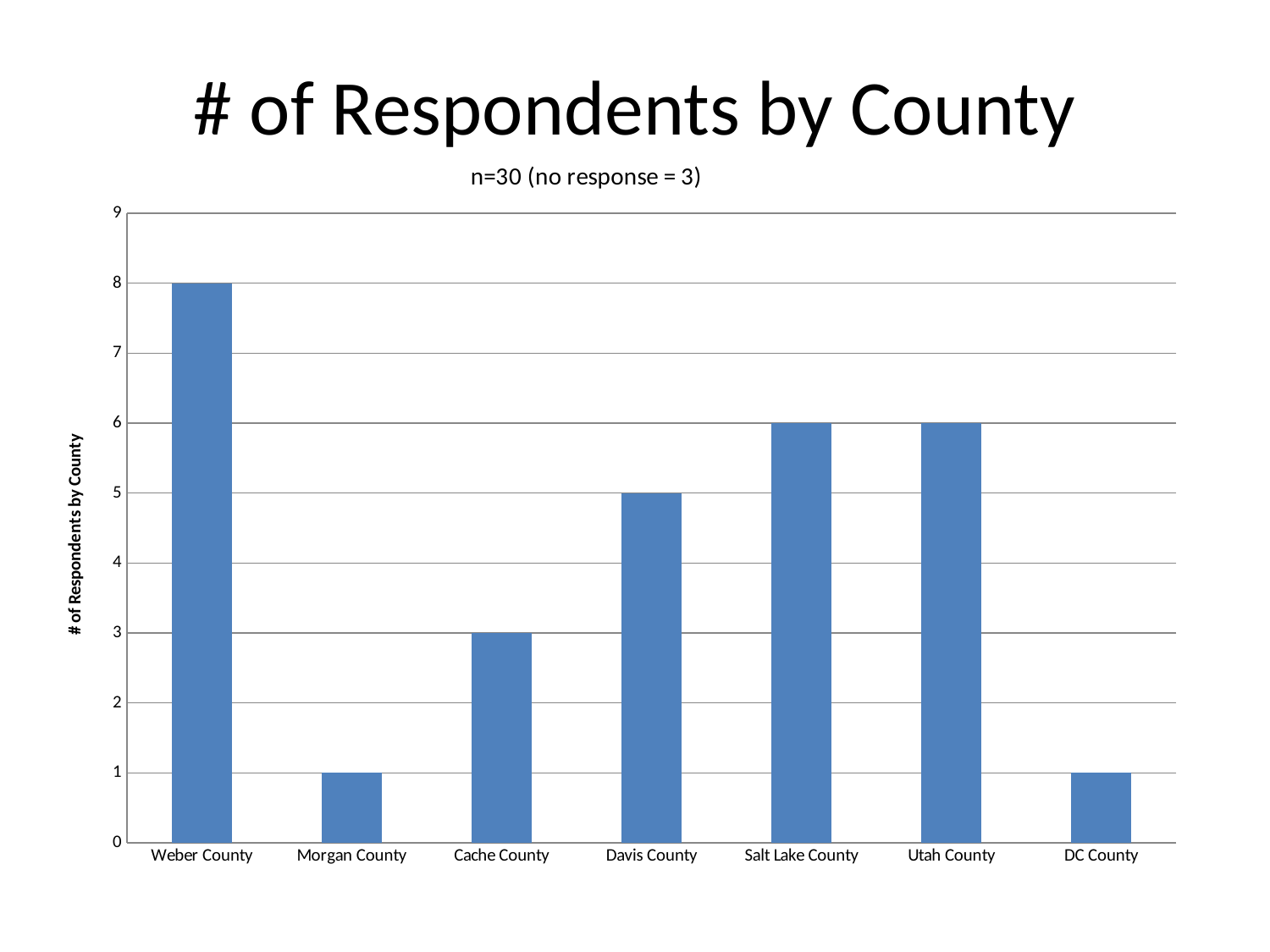
Which county has the highest number of respondents? Weber County How many respondents are from Weber County? 8 What kind of chart is shown on the slide? Bar chart How many respondents are from Davis County? 5 How many respondents are from Salt Lake County? 6 What is the title of the chart? # of Respondents by County What is the difference in respondents between Weber County and Davis County? 3 Is the value for Utah County greater or less than 4? greater How many counties are shown on the x axis? 7 What sample size is stated in the chart subtitle? n=30 (no response = 3) Which has more respondents, Davis County or Cache County? Davis County How many respondents are from Cache County? 3